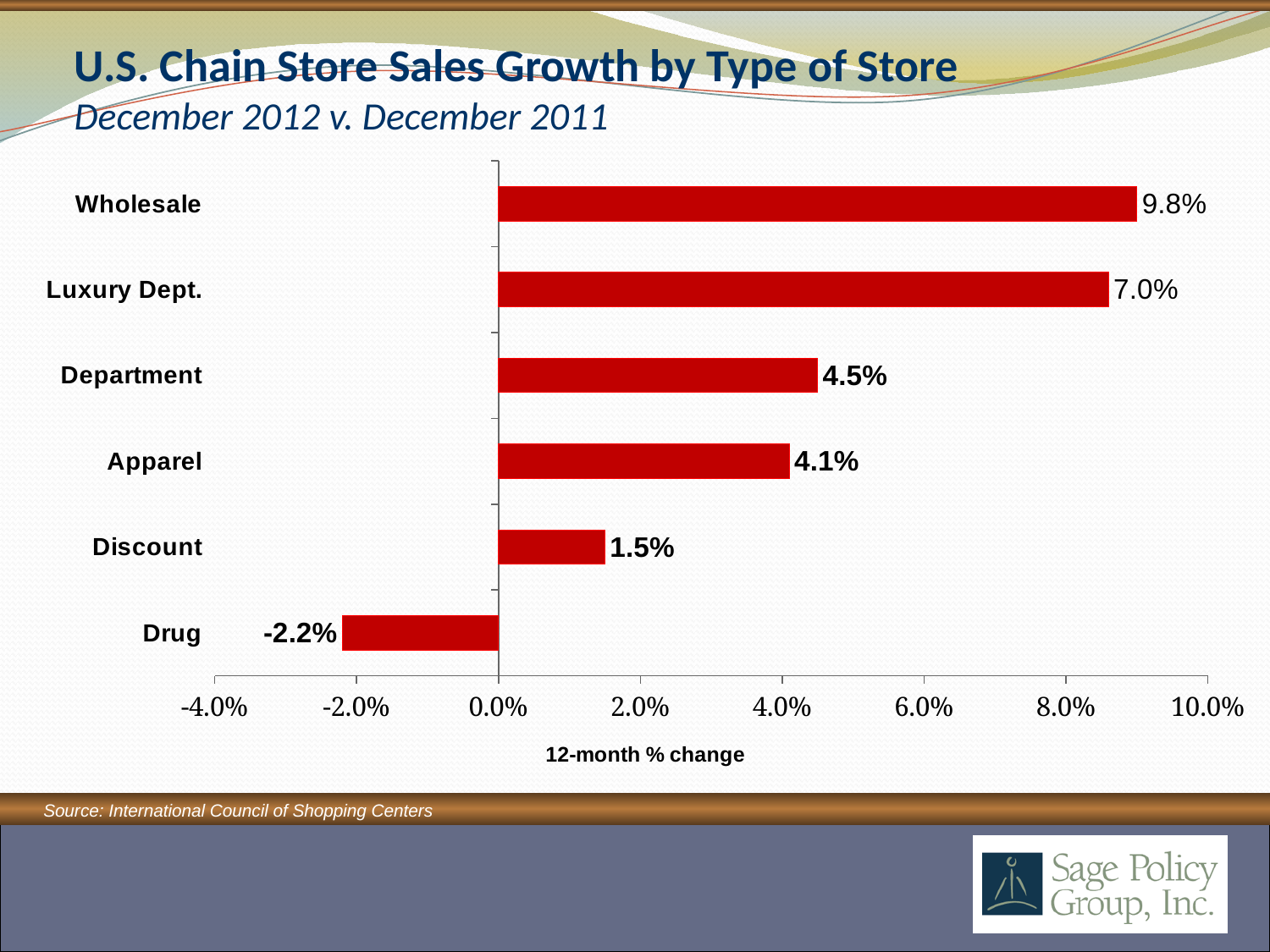
Which type of store has the lowest sales growth? Drug What is the difference between the Department and Apparel growth rates? 0.4% What is the 12-month % change for Drug stores? -2.2% What is the difference between the Wholesale and Luxury Dept. growth rates? 2.8% Which type of store has the highest sales growth? Wholesale What is the 12-month % change for Discount stores? 1.5% What is the 12-month % change for Wholesale? 9.8% What is the label of the horizontal axis? 12-month % change Which has a larger 12-month % change, Apparel or Discount? Apparel How many types of store are shown in the chart? 6 What kind of chart is shown on the slide? Bar chart What is the 12-month % change for Luxury Dept.? 7.0%